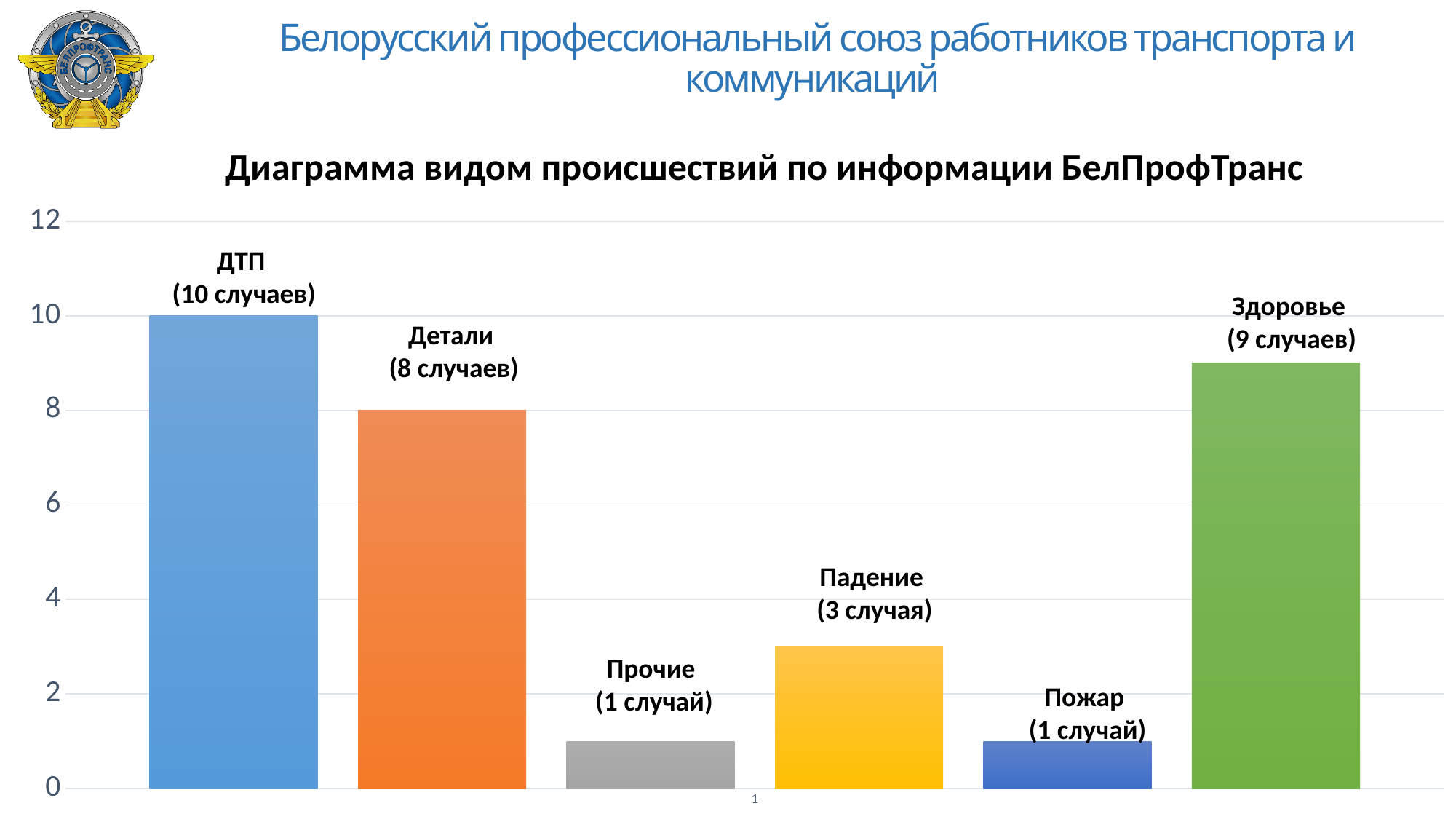
Which is larger, the value for Детали or the value for Здоровье? Здоровье What is the difference between the values for ДТП and Детали? 2 What type of chart is shown on the slide? bar chart How many cases are shown for Здоровье? 9 случаев How many cases are shown for Падение? 3 случая What is the difference between the values for Здоровье and Падение? 6 Is the value for Детали greater or less than 6? greater What is the title of the chart? Диаграмма видом происшествий по информации БелПрофТранс How many cases are shown for ДТП? 10 случаев Which category has the lowest value, Детали or Пожар? Пожар How many categories (bars) are shown in the chart? 6 Which category has the highest value? ДТП